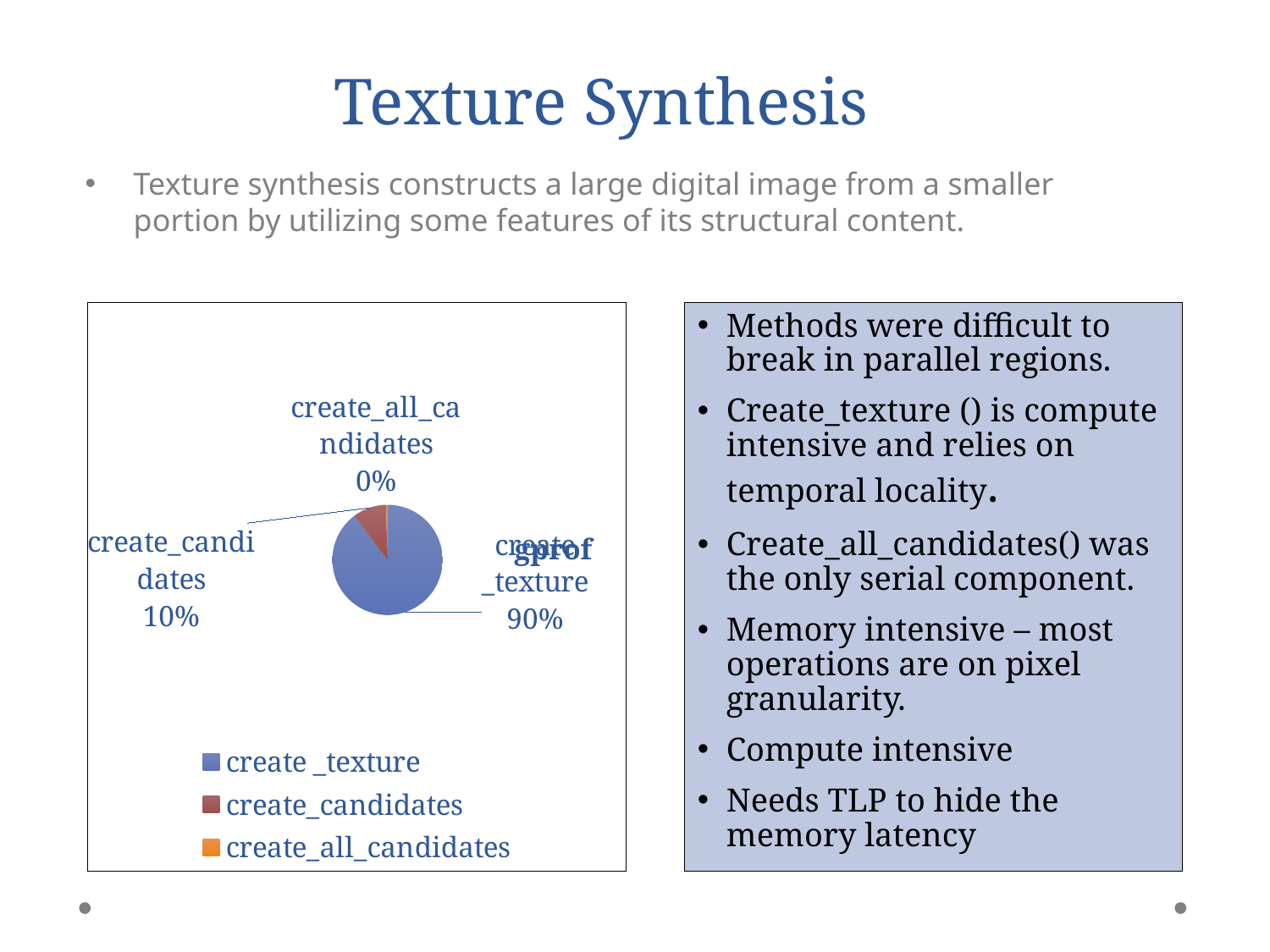
How many slices does the pie chart have? 3 What share of the pie does create_all_candidates have? 0% Which slice of the pie is the smallest? create_all_candidates Which slice of the pie is the largest? create_texture What kind of chart is shown on the slide? pie chart What share of the pie does create_texture have? 90% What is the difference in percentage points between the create_texture and create_candidates slices? 80 How many entries does the legend list? 3 What is the title of the pie chart? gprof Which legend entry is shown in orange? create_all_candidates Which is larger, the create_candidates slice or the create_all_candidates slice? create_candidates What share of the pie does create_candidates have? 10%